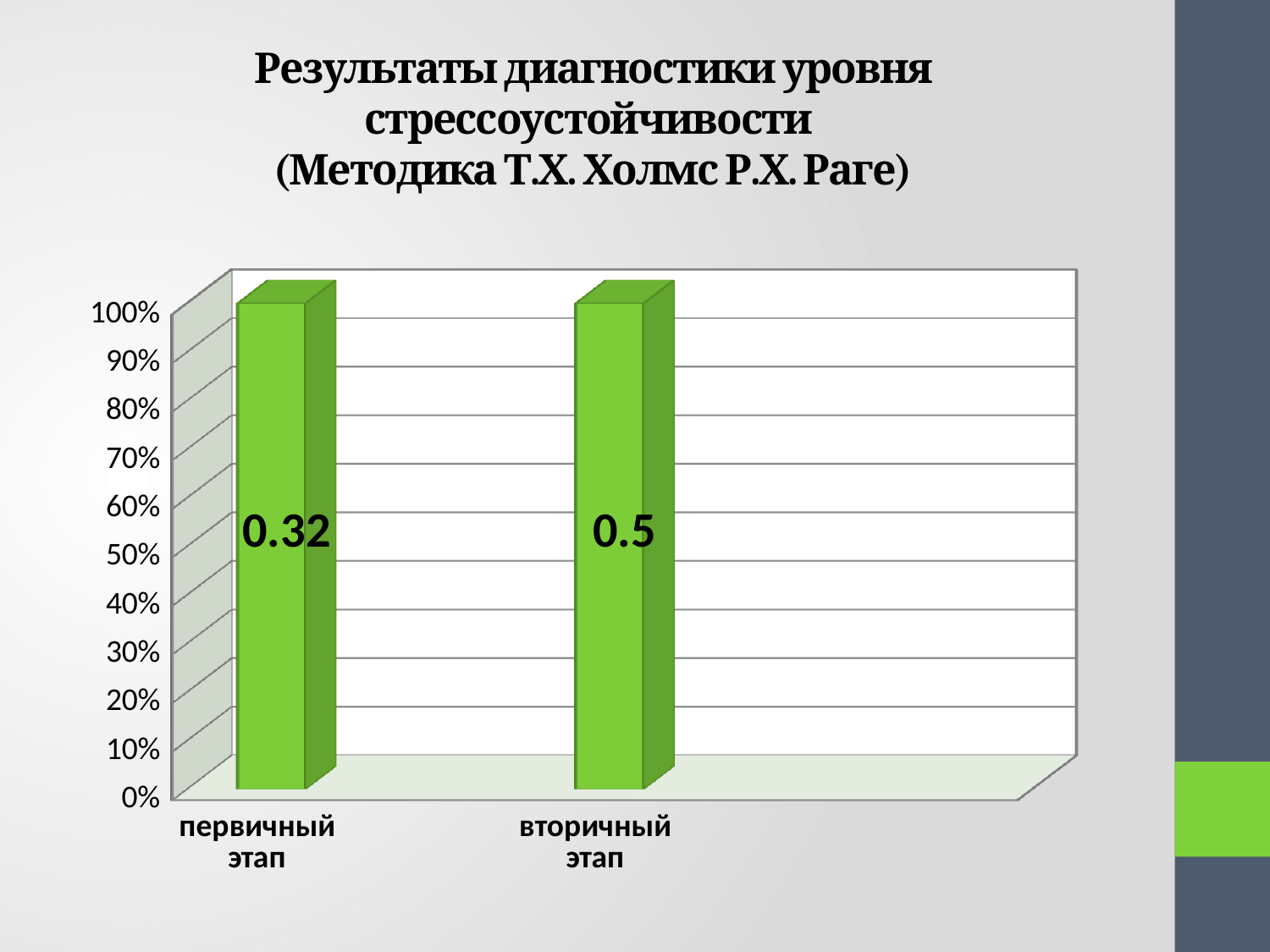
What is the highest value shown on the vertical axis of the chart? 100% What kind of chart is shown on the slide? bar chart Which category has the larger printed data label, первичный этап or вторичный этап? вторичный этап What is the data label on the bar for первичный этап? 0.32 What colour are the bars in the chart? green What is the data label on the bar for вторичный этап? 0.5 What is the difference between the printed data labels for вторичный этап and первичный этап? 0.18 What is the label of the first category on the x axis? первичный этап What is the label of the second category on the x axis? вторичный этап How many categories are shown on the x axis of the chart? 2